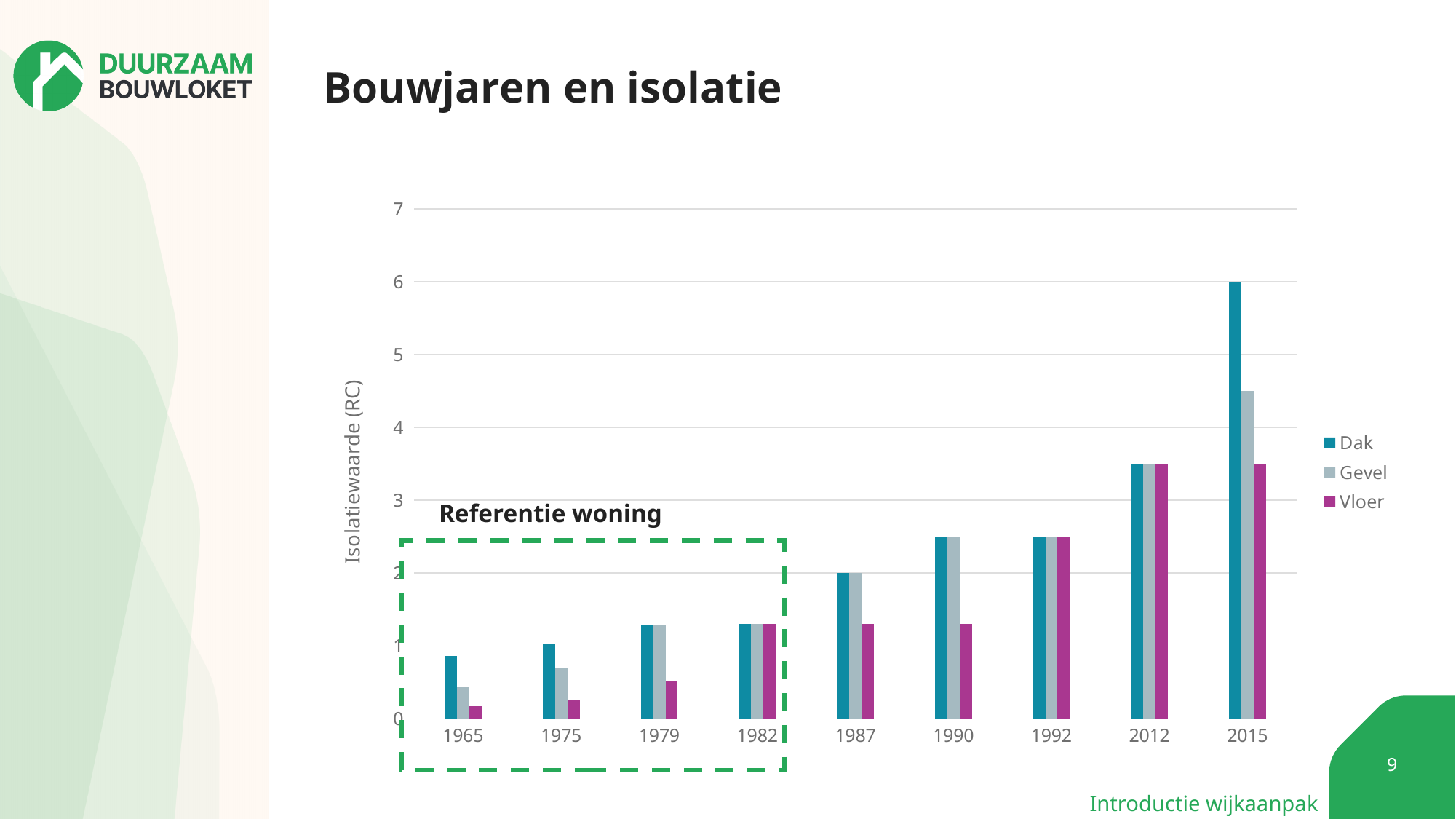
Which is larger in 2015, the Dak value or the Vloer value? Dak What kind of chart is shown on the slide? Bar chart Is the value for Vloer in 1965 greater or less than 1? less Do the Dak values generally rise or fall from 1965 to 2015? Rise In which year is the Dak value highest? 2015 How many series does the legend list? 3 Is the value for Dak in 2012 greater or less than 3? greater Is the value for Gevel in 2015 greater or less than 4? greater In which year is the Vloer value lowest? 1965 What is the Dak value for 2015? 6 How many years (categories) are shown on the x axis? 9 What is the Dak value for 1987? 2